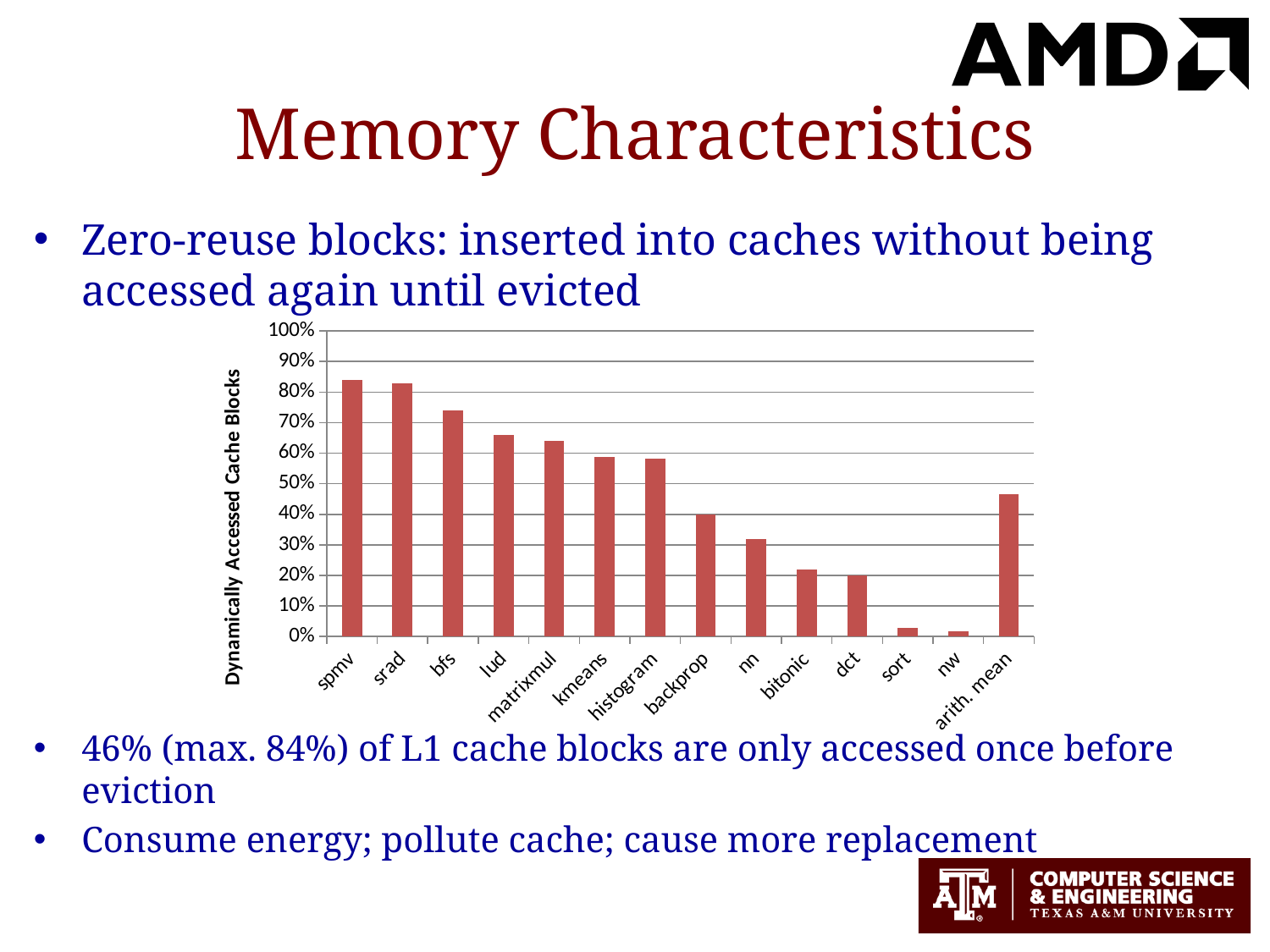
How many categories are plotted along the x axis of the chart? 14 What is the title of the vertical axis of the chart? Dynamically Accessed Cache Blocks Ignoring the arith. mean bar, do the values generally rise or fall from spmv on the left to nw on the right? fall Is the value for lud greater or less than 70%? less Which has the larger value, backprop or nn? backprop Is the value for dct greater or less than 10%? greater Is the value for backprop greater or less than 50%? less What kind of chart is shown on the slide? bar chart Which has the larger value, bfs or lud? bfs